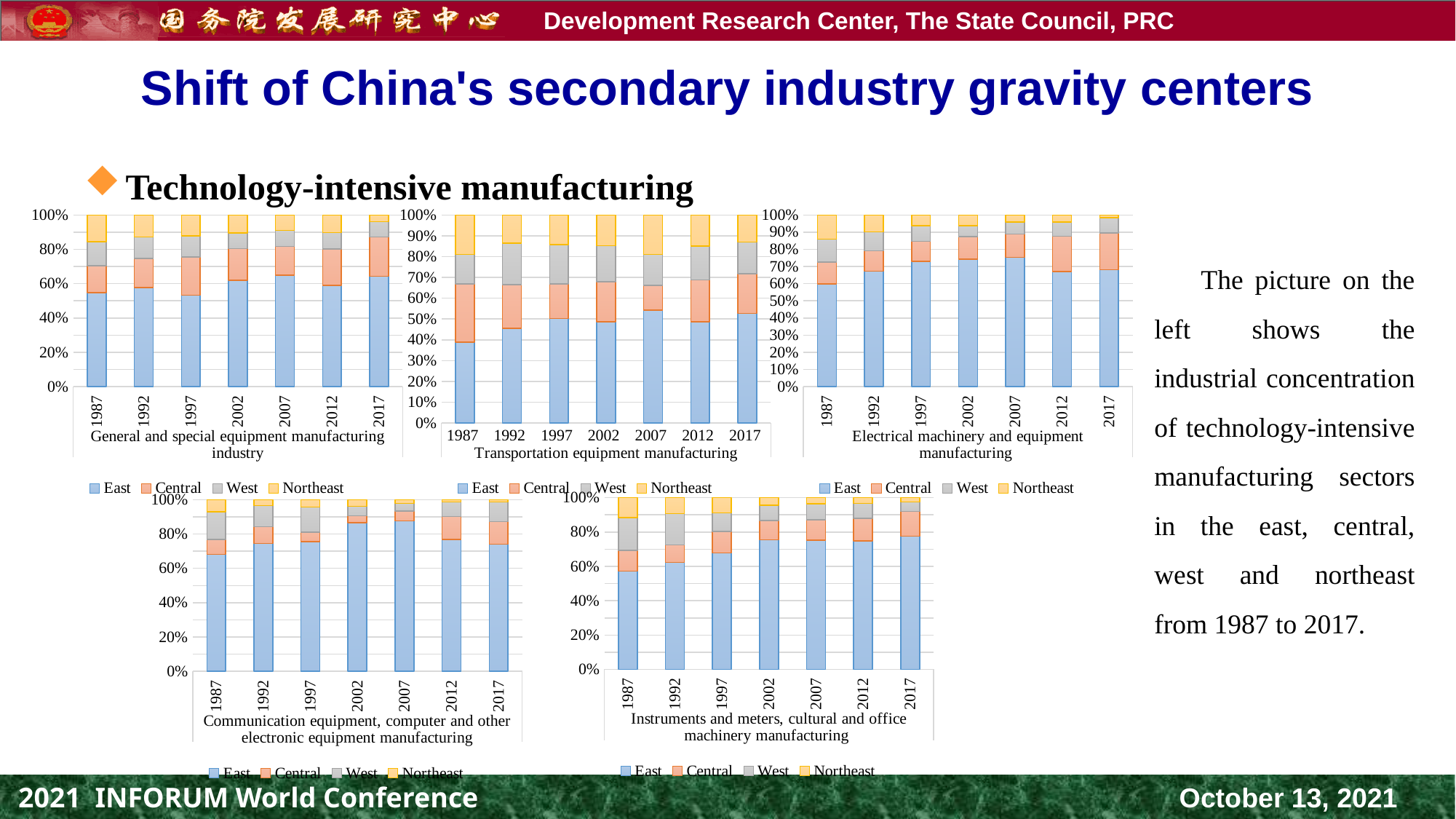
In the 'Transportation equipment manufacturing' chart, does the East share rise or fall from 1987 to 2007? rise In the 'Transportation equipment manufacturing' chart, which year has the lowest East share? 1987 What are the four legend entries of the 'Communication equipment, computer and other electronic equipment manufacturing' chart? East, Central, West, Northeast In the 'Electrical machinery and equipment manufacturing' chart, which year has the lowest East share? 1987 In the 'Electrical machinery and equipment manufacturing' chart, is the East share in 2007 greater or less than 70%? greater How many years are shown on the x axis of the 'Electrical machinery and equipment manufacturing' chart? 7 In the 'General and special equipment manufacturing industry' chart, is the East share in 1987 greater or less than 40%? greater How many series does the legend of the 'General and special equipment manufacturing industry' chart list? 4 In the 'Transportation equipment manufacturing' chart, is the East share in 1987 greater or less than 50%? less What kind of chart is the 'Transportation equipment manufacturing' chart? Stacked bar chart In the 'Instruments and meters, cultural and office machinery manufacturing' chart, what do the four stacked segments of each bar add up to? 100%